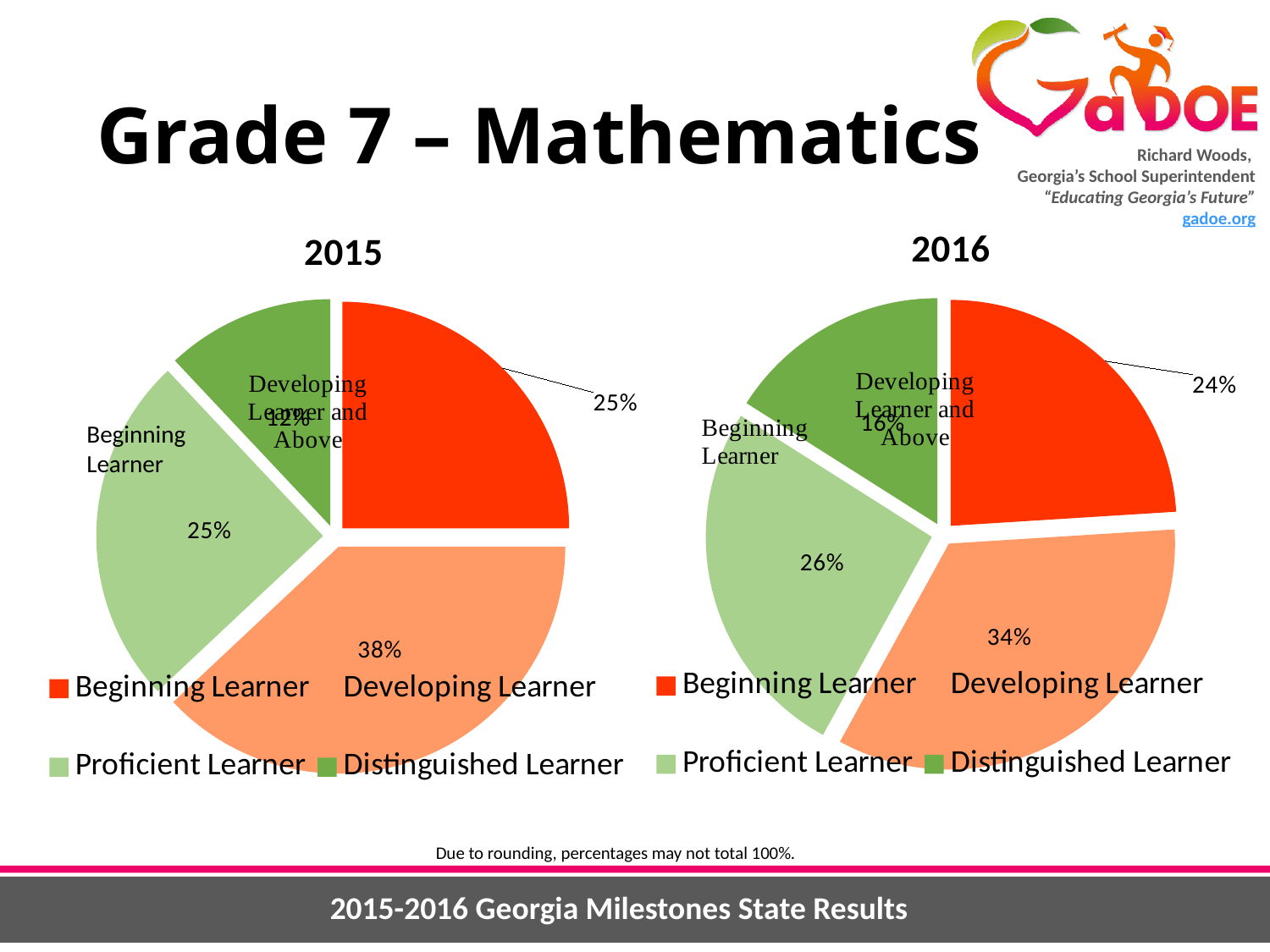
In the 2016 pie chart, which category has the smallest share? Distinguished Learner In the 2015 pie chart, what percentage is shown for Developing Learner? 38% Is the Developing Learner share larger in the 2015 chart or the 2016 chart? 2015 In the 2015 pie chart, which category has the largest share? Developing Learner In the 2016 pie chart, what percentage is shown for Distinguished Learner? 16% In the 2016 pie chart, what percentage is shown for Beginning Learner? 24% How many entries does the legend of the 2015 chart list? 4 What is the difference between the Developing Learner share in 2015 and in 2016? 4% What type of chart is used to show the 2015 results? Pie chart In the 2016 pie chart, what percentage is shown for Proficient Learner? 26% How many slices does the 2016 pie chart have? 4 In the 2016 pie chart, which is larger: Developing Learner or Proficient Learner? Developing Learner